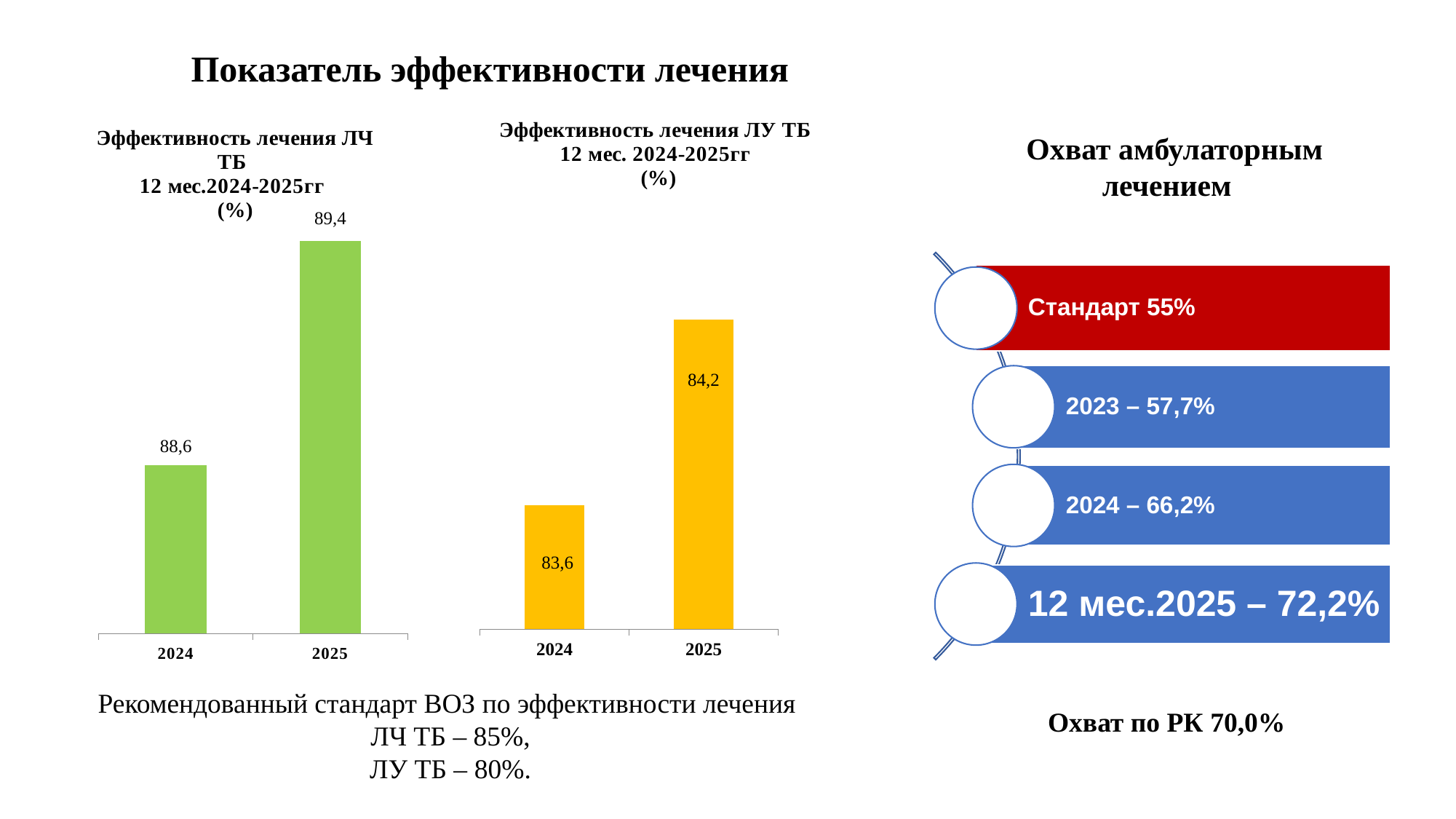
In the middle chart (Эффективность лечения ЛУ ТБ), what is the difference between the 2025 and 2024 values? 0,6 In the middle chart (Эффективность лечения ЛУ ТБ), which year has the lower value? 2024 In the left chart (Эффективность лечения ЛЧ ТБ), what is the value for 2024? 88,6 In the middle chart (Эффективность лечения ЛУ ТБ), do the values rise or fall from 2024 to 2025? rise In the middle chart (Эффективность лечения ЛУ ТБ), what is the value for 2025? 84,2 In the left chart (Эффективность лечения ЛЧ ТБ), what is the value for 2025? 89,4 What type of chart is the left chart (Эффективность лечения ЛЧ ТБ)? bar chart In the middle chart (Эффективность лечения ЛУ ТБ), what is the value for 2024? 83,6 In the left chart (Эффективность лечения ЛЧ ТБ), which year has the higher value? 2025 How many bars are plotted in the middle chart (Эффективность лечения ЛУ ТБ)? 2 Is the 2025 value in the left chart (ЛЧ ТБ) larger or smaller than the 2025 value in the middle chart (ЛУ ТБ)? larger In the left chart (Эффективность лечения ЛЧ ТБ), by how much does the 2025 value exceed the 2024 value? 0,8